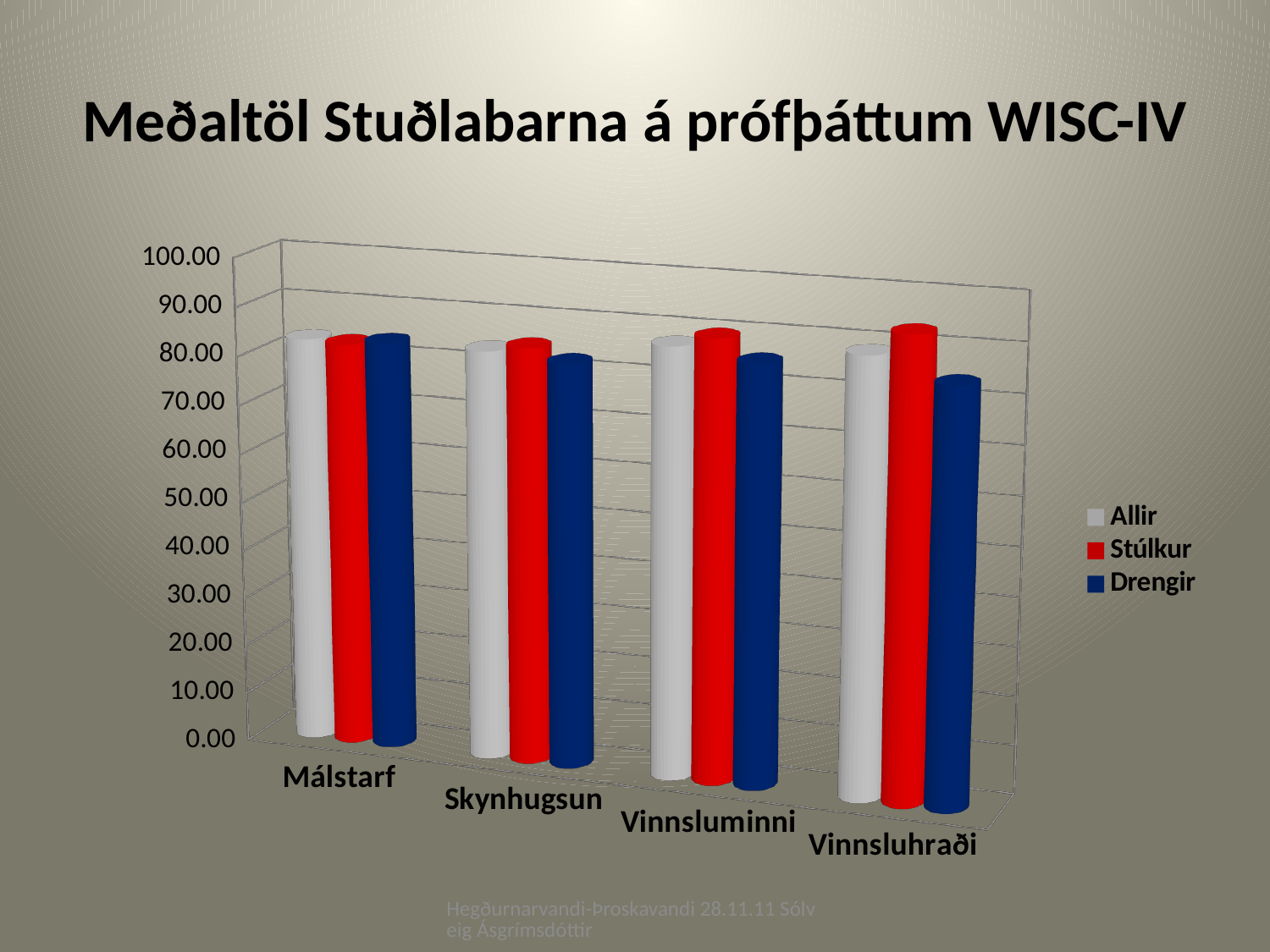
What kind of chart is shown on the slide? bar chart Is the value for Allir in Málstarf greater or less than 70? greater Is the value for Drengir in Skynhugsun greater or less than 90? less How many categories are shown on the x axis of the chart? 4 Is the value for Drengir in Vinnsluhraði greater or less than 60? greater For Vinnsluhraði, which is larger: the value for Stúlkur or the value for Drengir? Stúlkur What is the title of the chart? Meðaltöl Stuðlabarna á prófþáttum WISC-IV Which series is shown in red in the chart? Stúlkur How many series does the legend list? 3